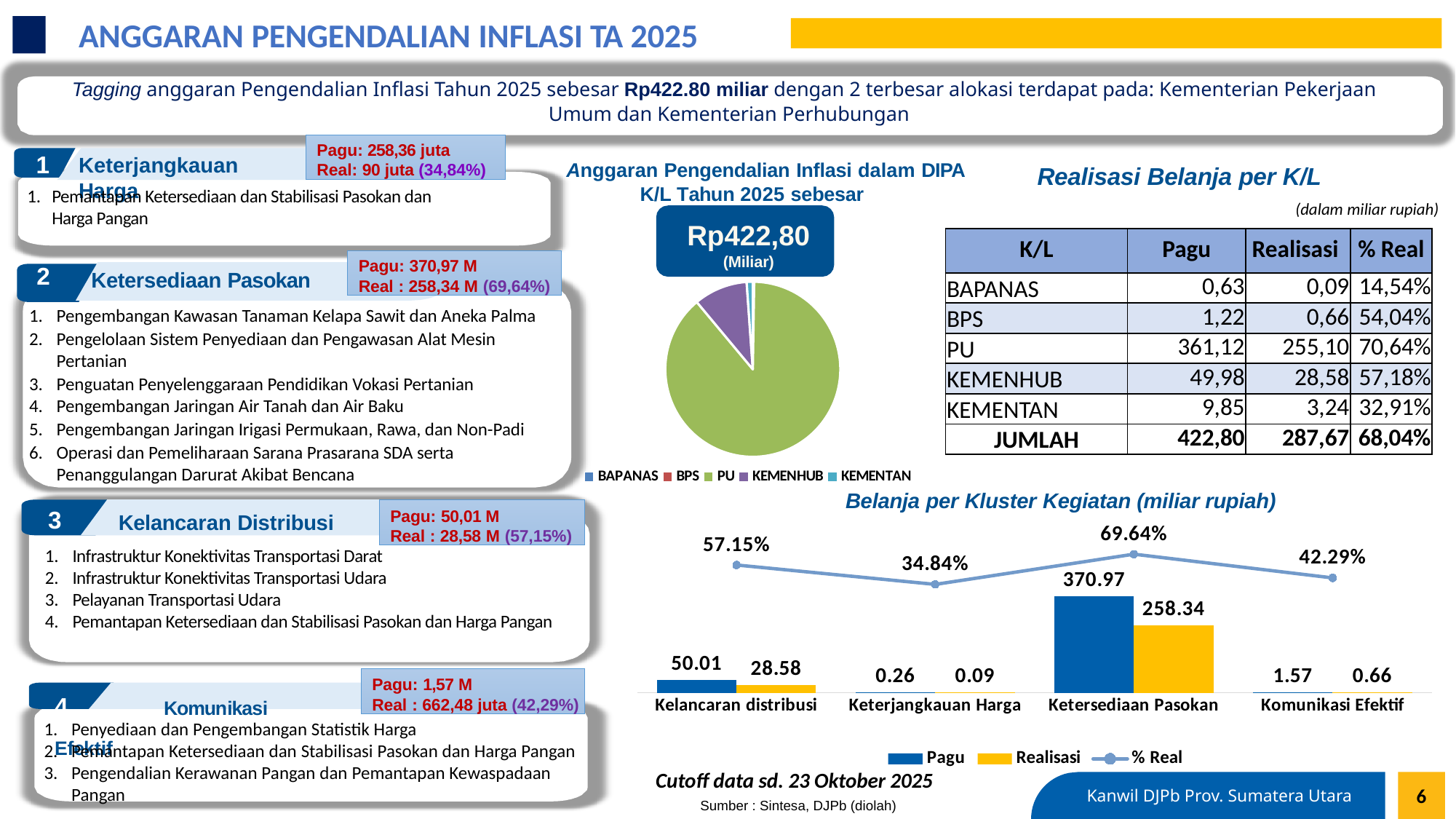
In the 'Belanja per Kluster Kegiatan' chart, what is the difference between Pagu and Realisasi for Ketersediaan Pasokan? 112.63 How many series does the legend of the 'Belanja per Kluster Kegiatan' chart list? 3 In the 'Belanja per Kluster Kegiatan' chart, which cluster has the lowest % Real? Keterjangkauan Harga How many clusters are shown on the x axis of the 'Belanja per Kluster Kegiatan' chart? 4 In the 'Anggaran Pengendalian Inflasi dalam DIPA K/L Tahun 2025' pie chart, which K/L has the largest slice? PU In the 'Belanja per Kluster Kegiatan' chart, which has the higher % Real: Kelancaran distribusi or Komunikasi Efektif? Kelancaran distribusi In the 'Belanja per Kluster Kegiatan' chart, which cluster has the highest Pagu? Ketersediaan Pasokan What kind of chart is the 'Anggaran Pengendalian Inflasi dalam DIPA K/L Tahun 2025' chart? pie chart In the 'Belanja per Kluster Kegiatan' chart, what is the Realisasi value for Komunikasi Efektif? 0.66 In the 'Belanja per Kluster Kegiatan' chart, what is the Realisasi value for Kelancaran distribusi? 28.58 In the 'Belanja per Kluster Kegiatan' chart, what is the Pagu value for Ketersediaan Pasokan? 370.97 In the 'Belanja per Kluster Kegiatan' chart, what is the % Real value for Keterjangkauan Harga? 34.84%